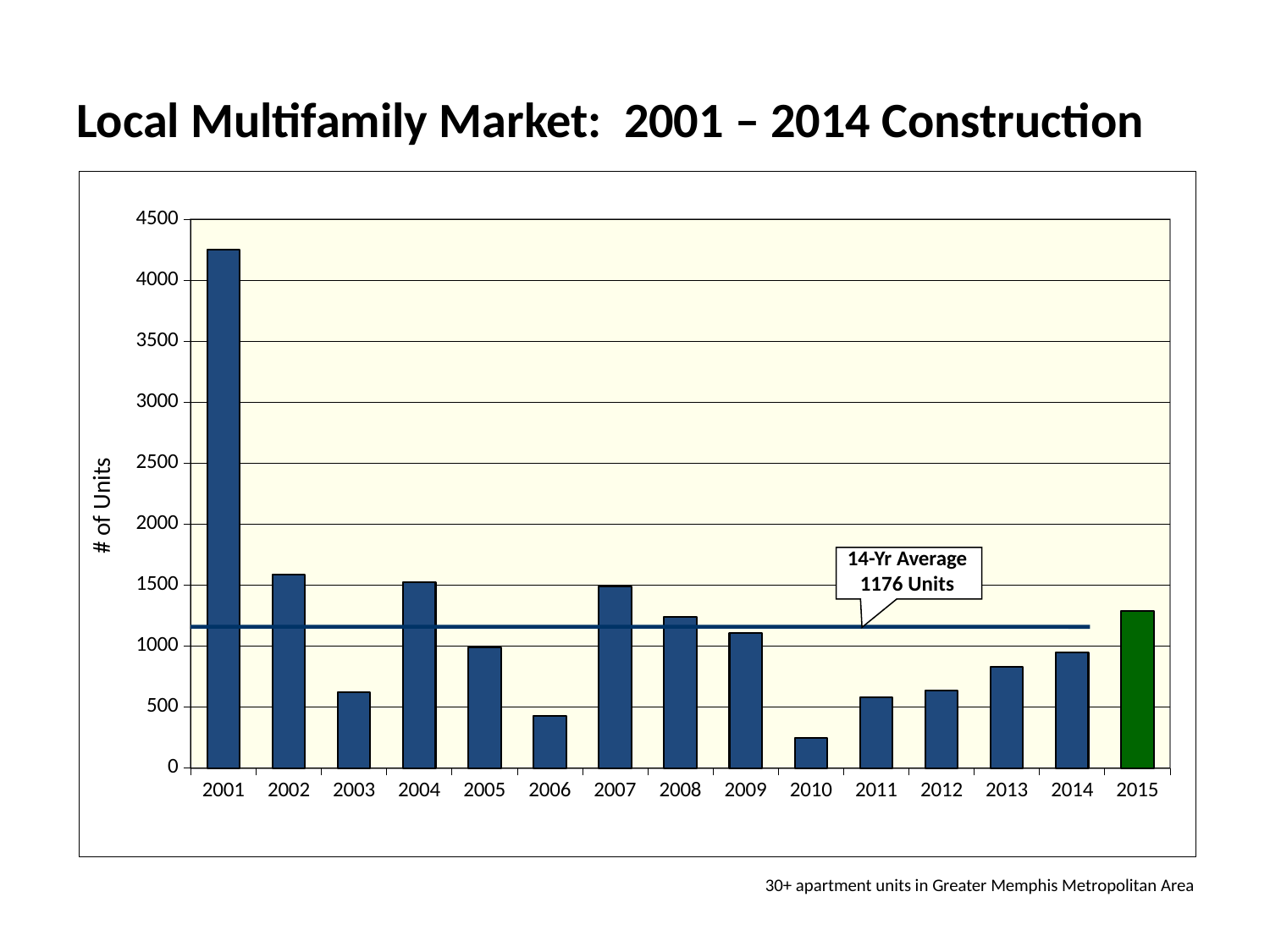
What is the 14-year average number of units shown in the callout on the chart? 1176 Units Is the value for 2006 greater or less than 500? less Which year has more units, 2007 or 2009? 2007 What is the label on the vertical axis of the chart? # of Units What kind of chart is shown on the slide? Bar chart How many years (bars) are plotted on the chart? 15 Is the value for 2002 greater or less than 1500? greater Which year has the lowest number of units? 2010 Which year has the highest number of units? 2001 Is the value for 2001 greater or less than 4000? greater Which year has more units, 2002 or 2003? 2002